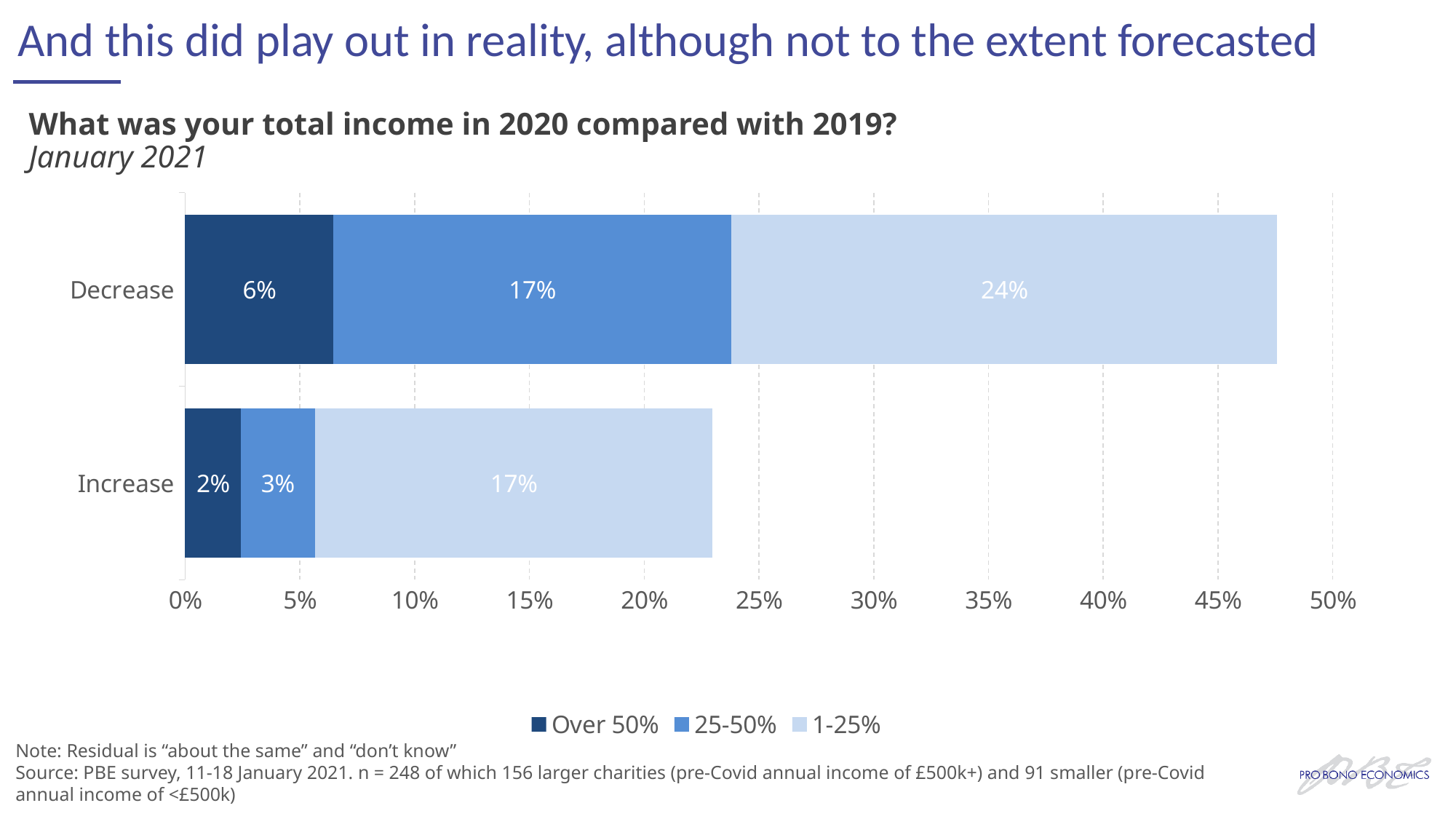
What is the value for the '25-50%' series in the Increase bar? 3% What kind of chart is shown on the slide? Stacked bar chart What is the value for the 'Over 50%' series in the Decrease bar? 6% What is the value for the '1-25%' series in the Increase bar? 17% What is the value for the '25-50%' series in the Decrease bar? 17% Which category has the larger '1-25%' segment, Decrease or Increase? Decrease What is the difference between the '1-25%' values for Decrease and Increase? 7% What is the title of the chart? What was your total income in 2020 compared with 2019? How many series does the legend list? 3 What is the total of the Decrease stacked bar? 47% How many categories are shown on the y axis? 2 What is the total of the Increase stacked bar? 22%